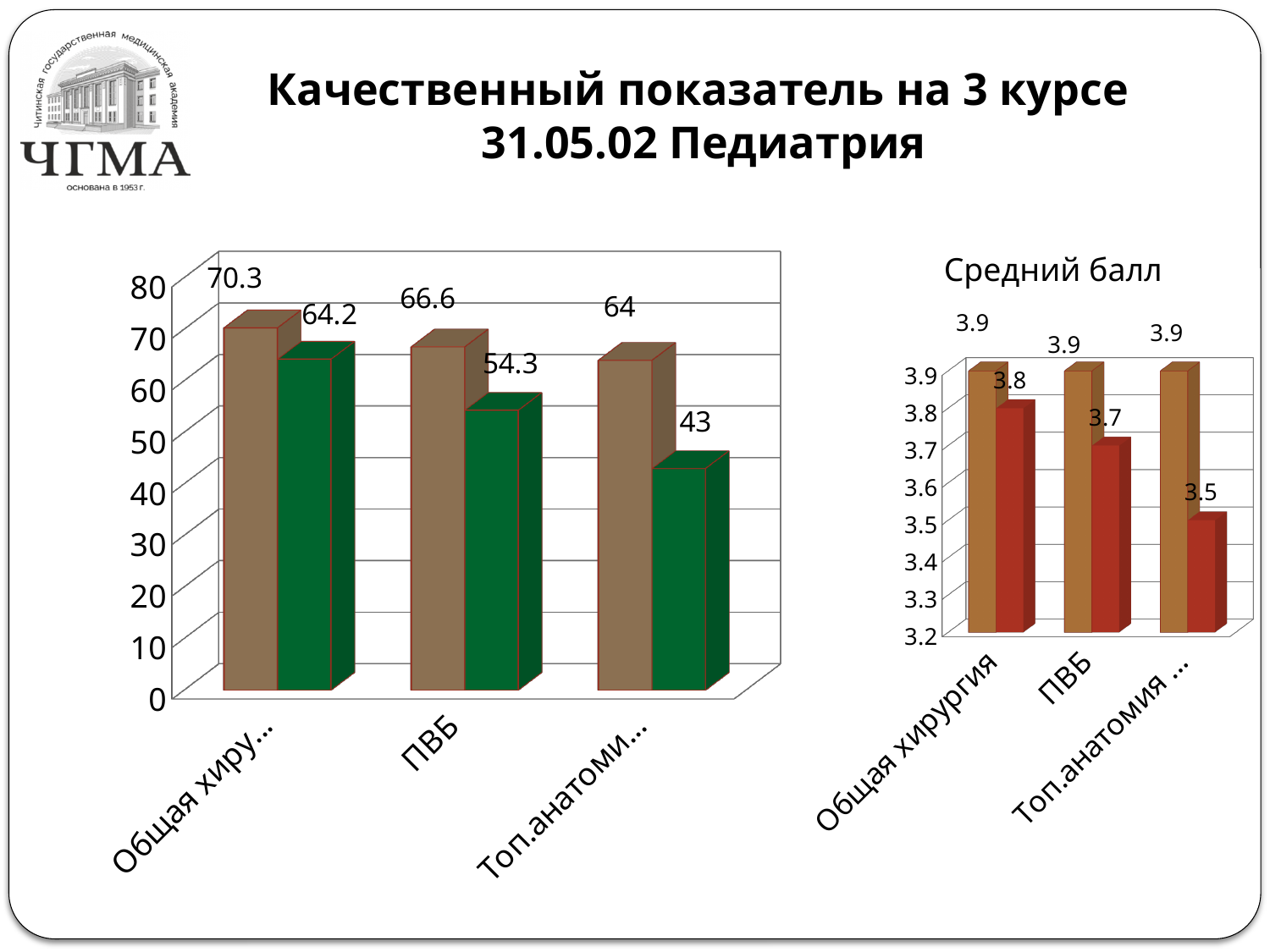
What kind of chart is the left chart? bar chart On the chart titled Средний балл, what is the difference between the brown and red bars for Топ.анатомия ...? 0.4 On the left chart, how many categories are shown on the x axis? 3 On the left chart, what is the value of the brown bar for ПВБ? 66.6 On the left chart, do the green bar values rise or fall from left to right along the x axis? fall On the left chart, what is the difference between the brown and green bars for ПВБ? 12.3 On the left chart, what is the value of the green bar for ПВБ? 54.3 On the left chart, which is larger for Топ.анатоми..., the brown bar or the green bar? the brown bar On the left chart, which category has the lowest green bar? Топ.анатоми... On the chart titled Средний балл, what is the value of the red bar for Общая хирургия? 3.8 On the left chart, what is the value of the green bar for the category Топ.анатоми...? 43 On the chart titled Средний балл, what is the value of the red bar for ПВБ? 3.7